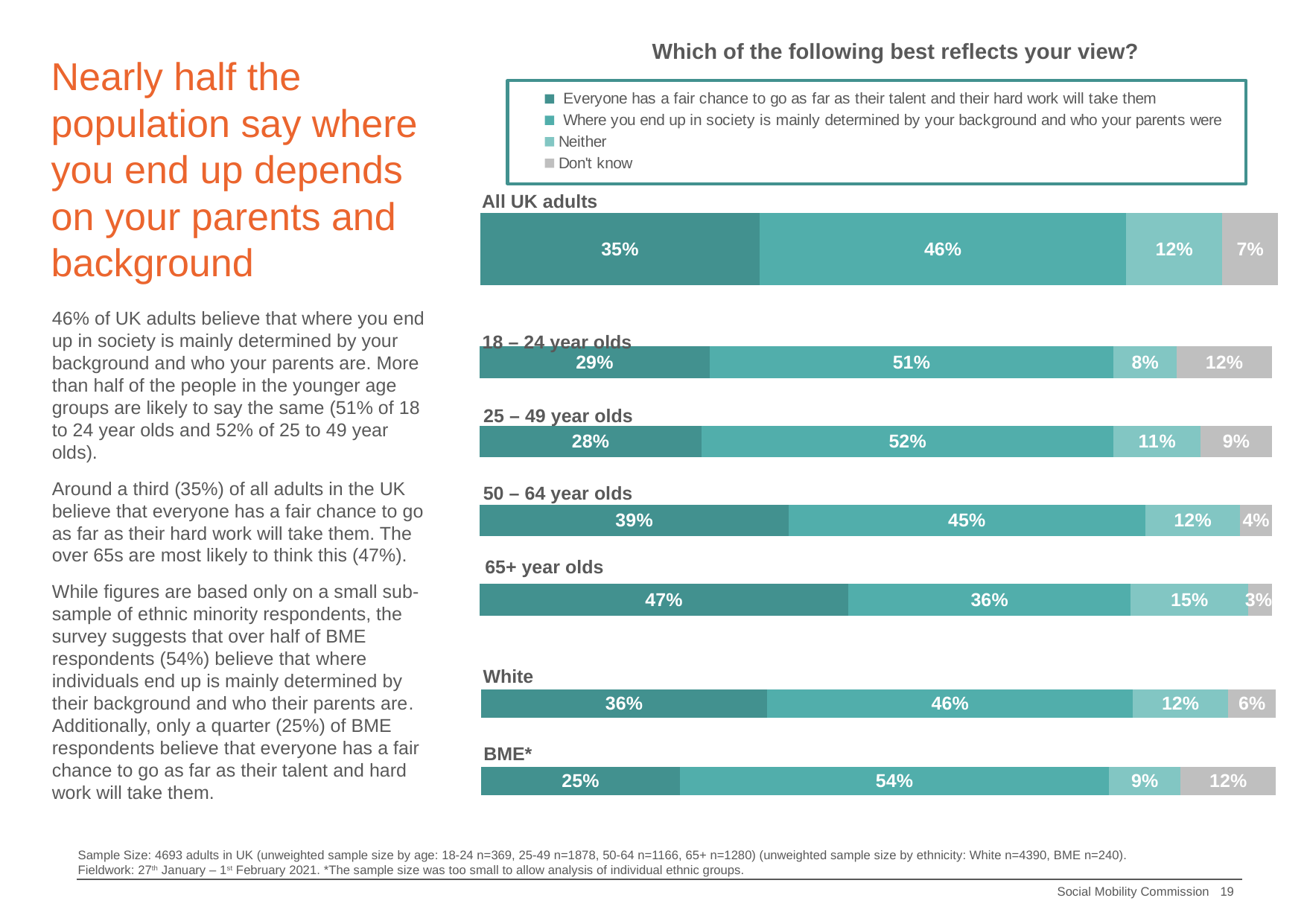
For 18 – 24 year olds, what is the difference in percentage points between those saying where you end up is determined by background (51%) and those saying everyone has a fair chance (29%)? 22 percentage points What type of chart is used to show the responses? Stacked bar chart What percentage of 65+ year olds say everyone has a fair chance to go as far as their talent and hard work will take them? 47% Which group has the lowest 'Don't know' percentage? 65+ year olds Which group has a larger share saying everyone has a fair chance: 50 – 64 year olds or 65+ year olds? 65+ year olds How many respondent groups (bars) are shown in the chart? 7 How many response options does the legend list? 4 For All UK adults, what percentage say where you end up in society is mainly determined by your background and who your parents were? 46% What percentage of BME* respondents answered 'Neither'? 9% What is the total of the four segments in the All UK adults bar? 100% Which group has the highest percentage saying where you end up is mainly determined by your background and who your parents were? BME* Which group has the highest percentage saying everyone has a fair chance to go as far as their talent and hard work will take them? 65+ year olds